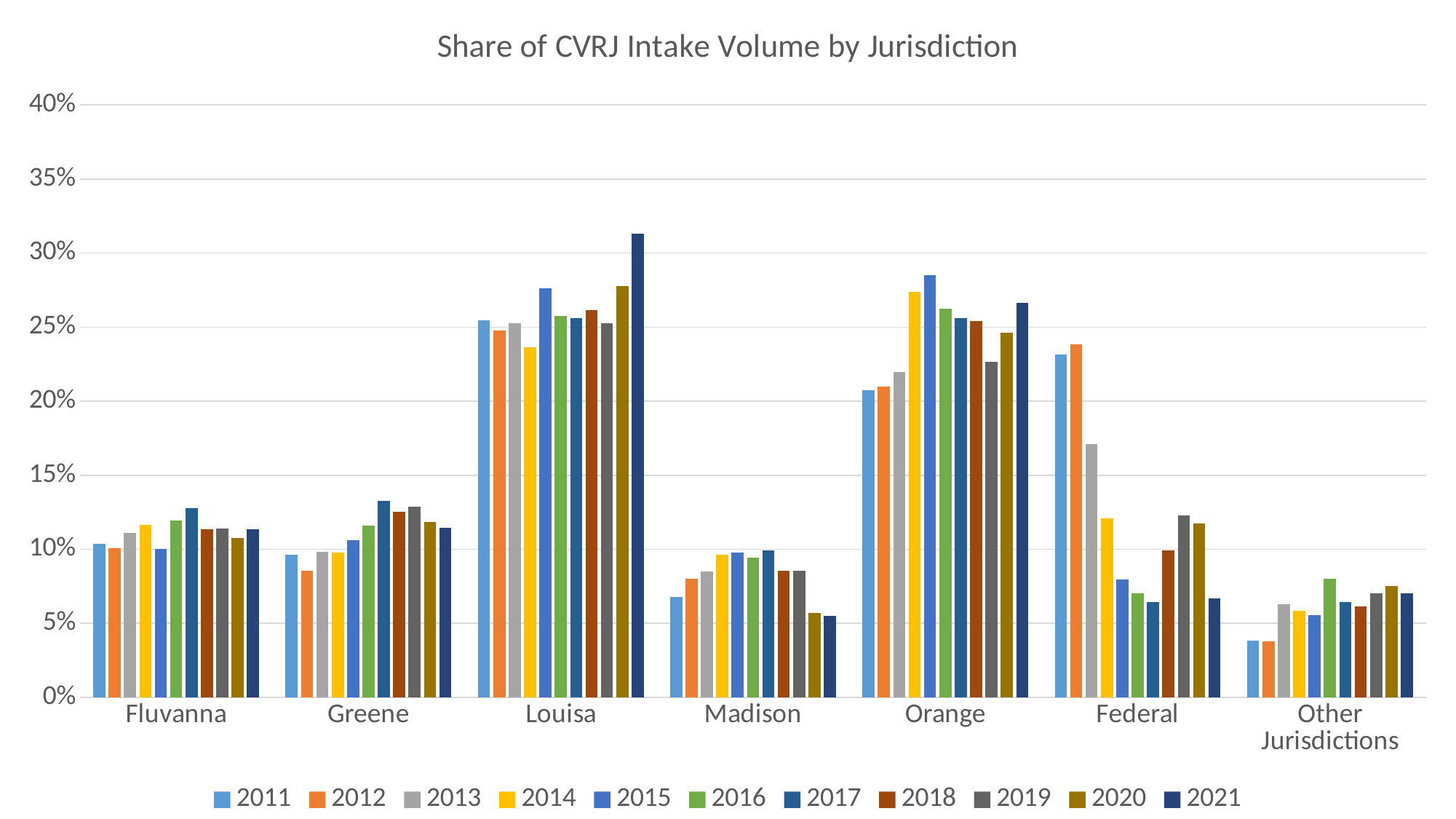
Is the value for Orange in 2015 greater or less than 25%? greater Which jurisdiction has the highest bar for 2021? Louisa Which jurisdiction has the lowest bar for 2011? Other Jurisdictions For Federal, which is larger: the 2012 value or the 2013 value? 2012 Is the value for Madison in 2021 greater or less than 10%? less Is the value for Louisa in 2021 greater or less than 30%? greater How many series (years) does the legend list? 11 How many jurisdiction categories are shown on the x axis? 7 What kind of chart is shown on the slide? bar chart What is the title of the chart? Share of CVRJ Intake Volume by Jurisdiction Which year is shown in yellow in the legend? 2014